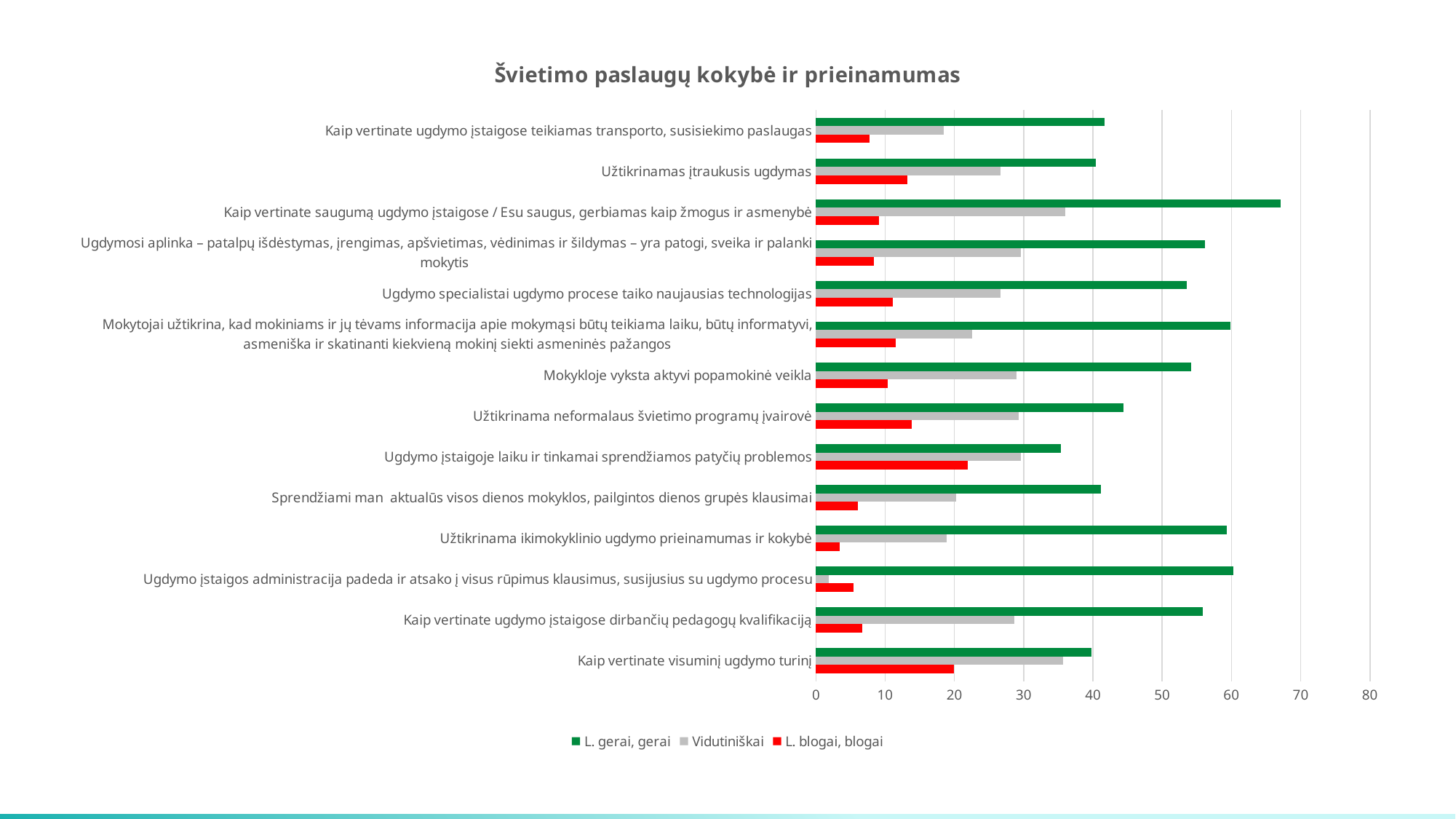
What is the title of the chart? Švietimo paslaugų kokybė ir prieinamumas Which has the larger 'L. gerai, gerai' value: 'Mokykloje vyksta aktyvi popamokinė veikla' or 'Užtikrinama neformalaus švietimo programų įvairovė'? Mokykloje vyksta aktyvi popamokinė veikla Is the 'L. blogai, blogai' value for 'Ugdymo įstaigoje laiku ir tinkamai sprendžiamos patyčių problemos' greater or less than 20? greater Which category has the highest value for the 'L. gerai, gerai' series? Kaip vertinate saugumą ugdymo įstaigose / Esu saugus, gerbiamas kaip žmogus ir asmenybė What kind of chart is shown on the slide? bar chart Which category has the lowest value for the 'Vidutiniškai' series? Ugdymo įstaigos administracija padeda ir atsako į visus rūpimus klausimus, susijusius su ugdymo procesu How many series does the legend list? 3 Is the 'Vidutiniškai' value for 'Kaip vertinate saugumą ugdymo įstaigose / Esu saugus, gerbiamas kaip žmogus ir asmenybė' greater or less than 30? greater Which category has the lowest value for the 'L. gerai, gerai' series? Ugdymo įstaigoje laiku ir tinkamai sprendžiamos patyčių problemos Is the 'L. gerai, gerai' value for 'Kaip vertinate ugdymo įstaigose teikiamas transporto, susisiekimo paslaugas' greater or less than 40? greater Which colour represents the 'L. blogai, blogai' series? red How many categories are plotted on the chart? 14